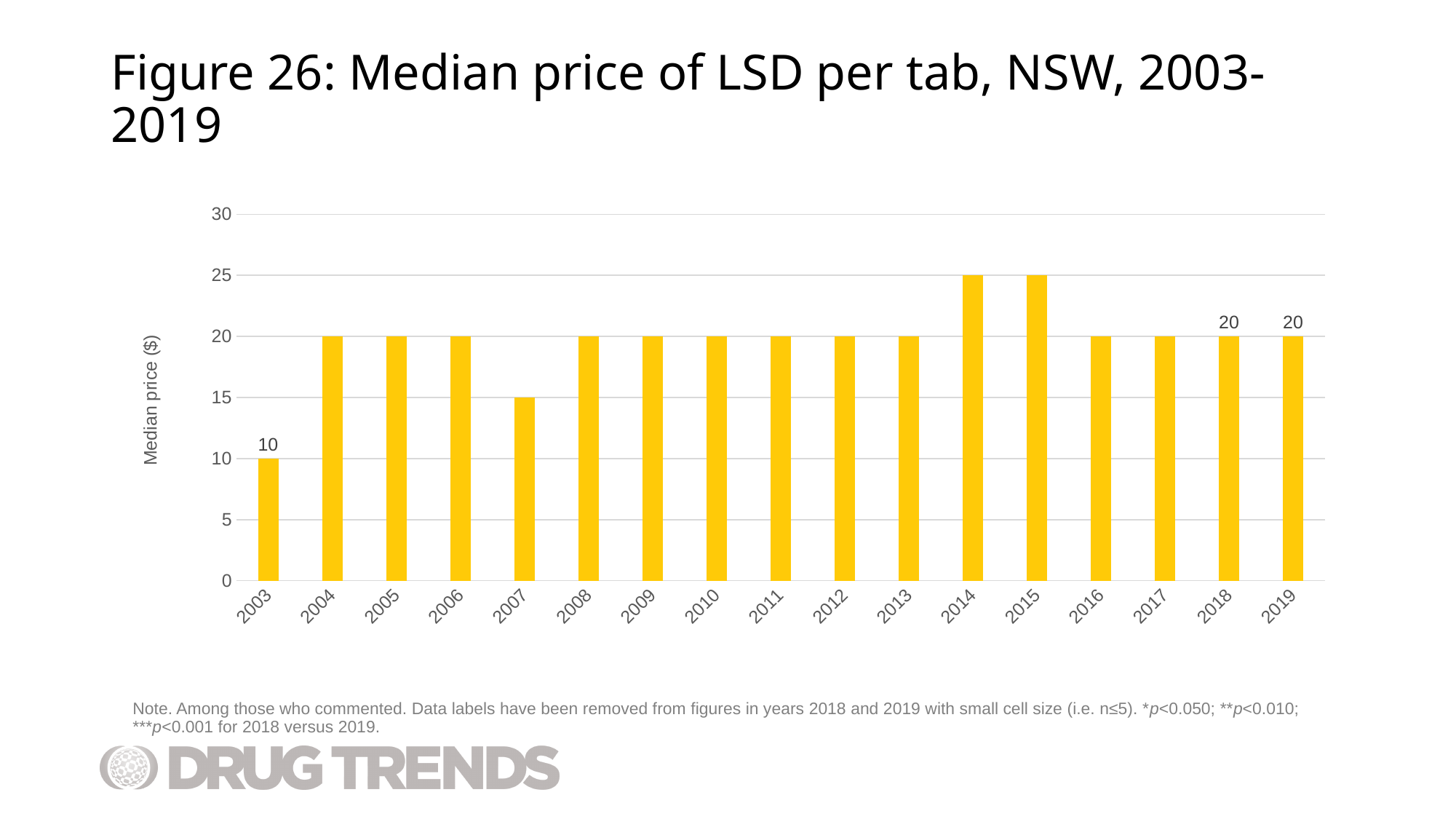
How many years are shown on the x axis of the chart? 17 What is the median price of LSD per tab in 2007? 15 What is the difference between the median price in 2019 and the median price in 2003? 10 What is the label of the y axis? Median price ($) What is the median price of LSD per tab in 2014? 25 What is the highest median price shown on the chart? 25 What type of chart is shown on the slide? bar chart What is the median price of LSD per tab in 2003? 10 Which year has the higher median price, 2007 or 2015? 2015 Is the median price in 2014 greater or less than 20? greater What is the median price of LSD per tab in 2018? 20 Which year has the lowest median price of LSD per tab? 2003